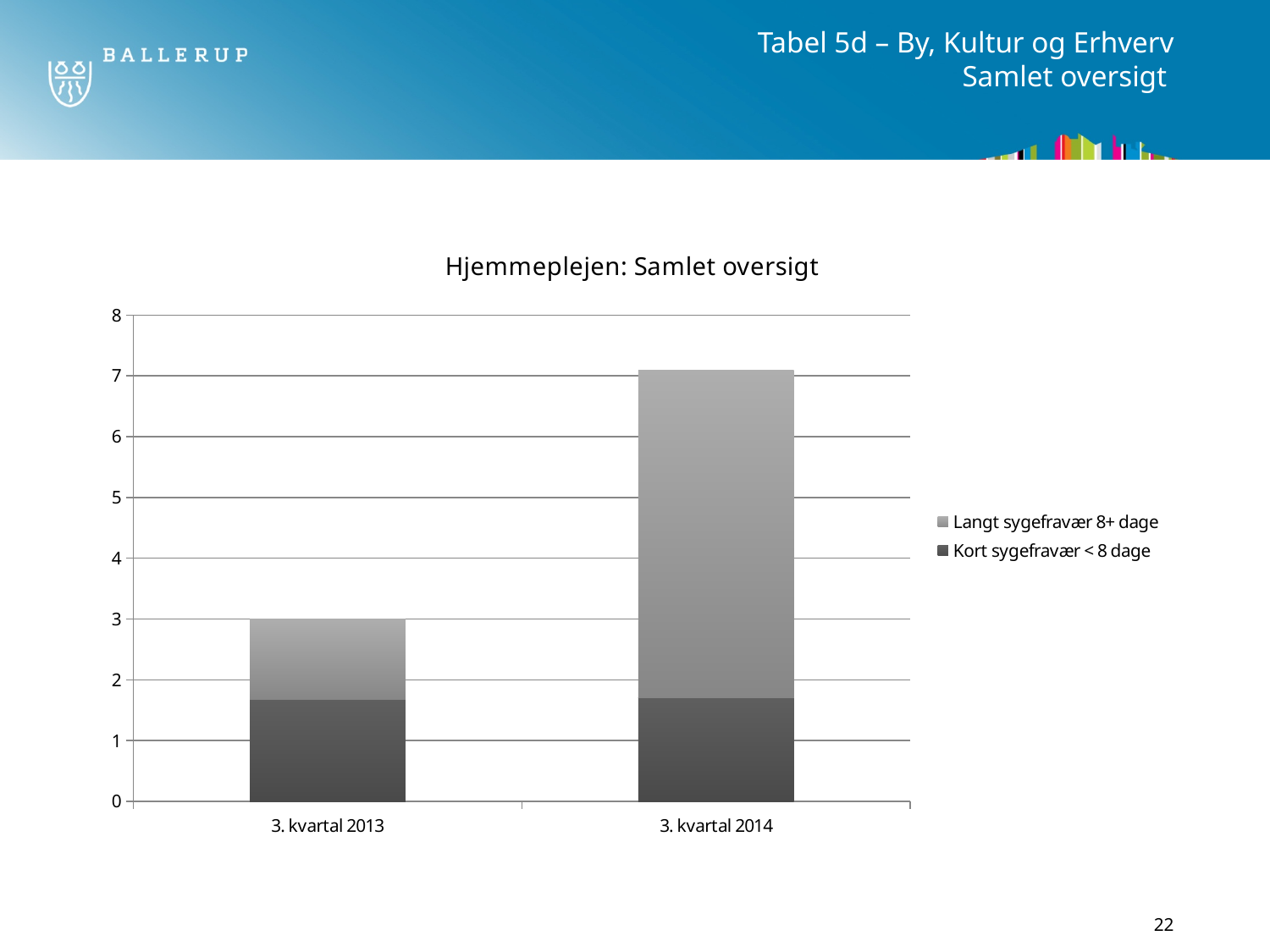
What is the title of the chart? Hjemmeplejen: Samlet oversigt What kind of chart is shown on the slide? Stacked bar chart How many categories are shown on the x axis of the chart? 2 Which category has the lowest total bar? 3. kvartal 2013 How many series does the legend list? 2 Is the total value for 3. kvartal 2013 greater or less than 4? less Which category has the highest total bar? 3. kvartal 2014 Is the Kort sygefravær < 8 dage value for 3. kvartal 2014 greater or less than 2? less Do the total bar values rise or fall from 3. kvartal 2013 to 3. kvartal 2014? rise Which series is shown in the lighter grey colour in the legend? Langt sygefravær 8+ dage Is the total value for 3. kvartal 2014 greater or less than 7? greater Which is larger: the Langt sygefravær 8+ dage value for 3. kvartal 2013 or for 3. kvartal 2014? 3. kvartal 2014